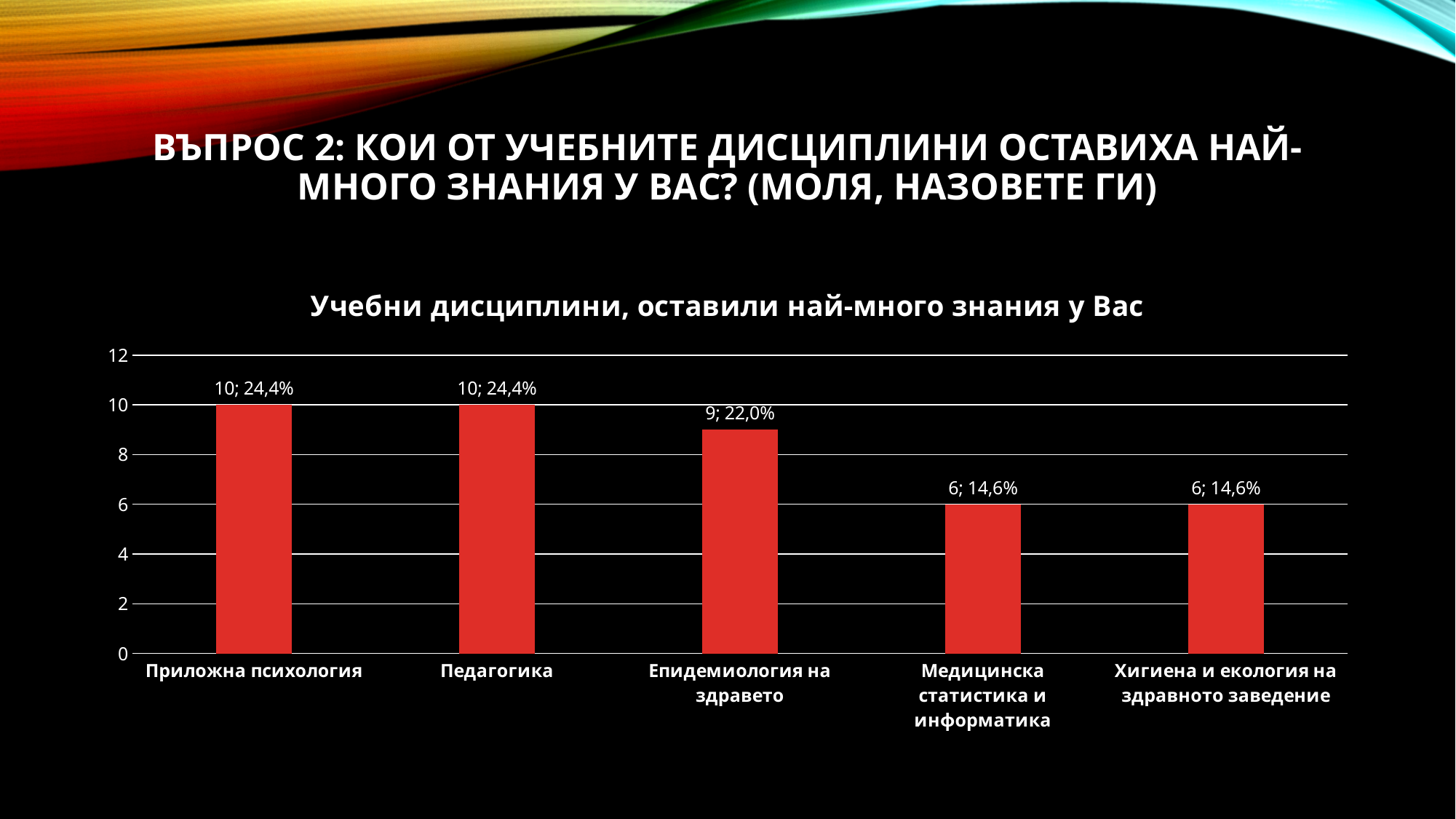
What kind of chart is shown on the slide? Bar chart What is the difference between the count for Педагогика and the count for Медицинска статистика и информатика? 4 What count is shown for Хигиена и екология на здравното заведение? 6 What is the difference between the count for Приложна психология and the count for Епидемиология на здравето? 1 What value is shown for Приложна психология? 10; 24,4% What value is shown for Епидемиология на здравето? 9; 22,0% What is the title of the chart? Учебни дисциплини, оставили най-много знания у Вас How many categories are shown on the chart? 5 Which has a larger count, Педагогика or Епидемиология на здравето? Педагогика What percentage is shown for Медицинска статистика и информатика? 14,6% Do the values rise or fall from left to right across the categories? Fall Which has a larger count, Епидемиология на здравето or Хигиена и екология на здравното заведение? Епидемиология на здравето